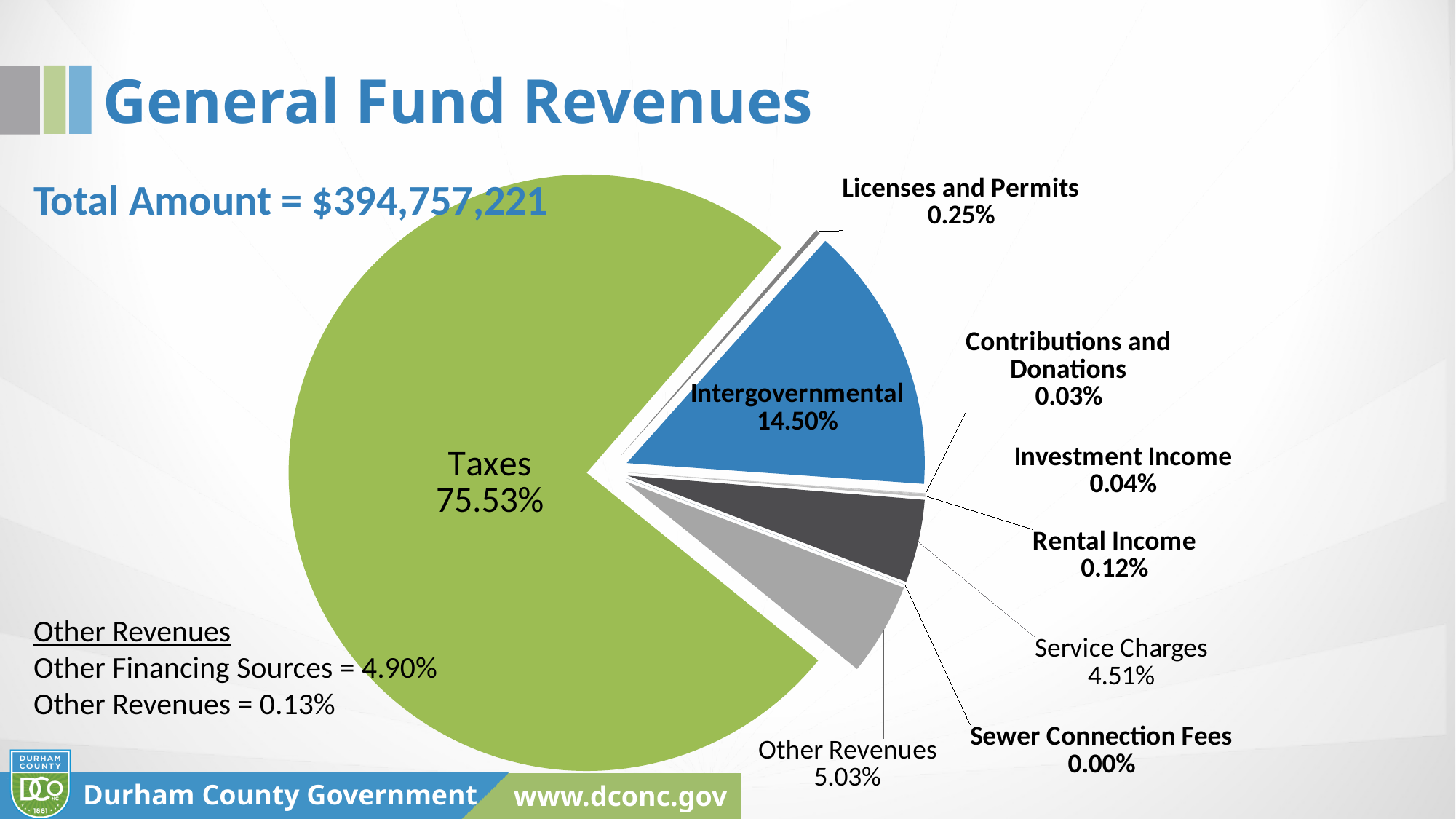
What percentage of the pie is Intergovernmental? 14.50% What is the value shown for Service Charges? 4.51% What is the value shown for Sewer Connection Fees? 0.00% What share of General Fund Revenues comes from Taxes? 75.53% How many categories are labelled in the pie chart? 9 What total amount is stated on the slide for General Fund Revenues? $394,757,221 What percentage is shown for Licenses and Permits? 0.25% Which category has the smallest value in the pie chart? Sewer Connection Fees What kind of chart is shown on the slide? Pie chart Which is larger, Other Revenues or Service Charges? Other Revenues Which category has the largest slice of the pie? Taxes What is the difference between the Taxes share and the Intergovernmental share? 61.03%